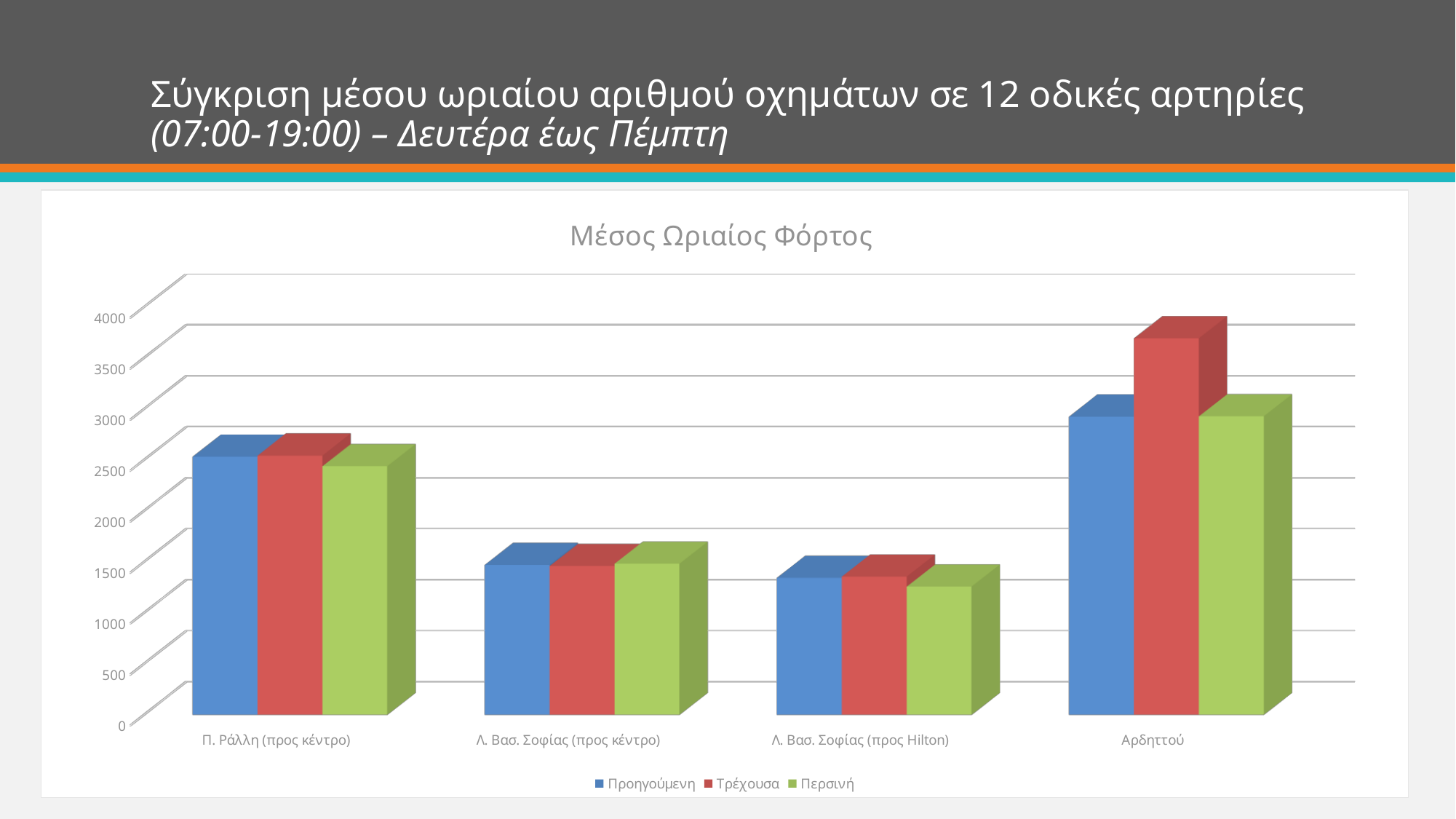
Which colour represents the Τρέχουσα series in the legend? Red Is the Περσινή value for Λ. Βασ. Σοφίας (προς Hilton) greater or less than 2000? less What type of chart is shown on the slide? Bar chart Is the Προηγούμενη value for Π. Ράλλη (προς κέντρο) greater or less than 2000? greater Is the Τρέχουσα value for Αρδηττού greater or less than 3500? greater How many road categories are shown on the x axis? 4 What is the title of the chart? Μέσος Ωριαίος Φόρτος Which category has the lowest value for the Περσινή series? Λ. Βασ. Σοφίας (προς Hilton) For the Περσινή series, which is larger: Π. Ράλλη (προς κέντρο) or Λ. Βασ. Σοφίας (προς κέντρο)? Π. Ράλλη (προς κέντρο) Which category has the highest value for the Τρέχουσα series? Αρδηττού For Αρδηττού, which is larger: Προηγούμενη or Τρέχουσα? Τρέχουσα How many series does the legend list? 3